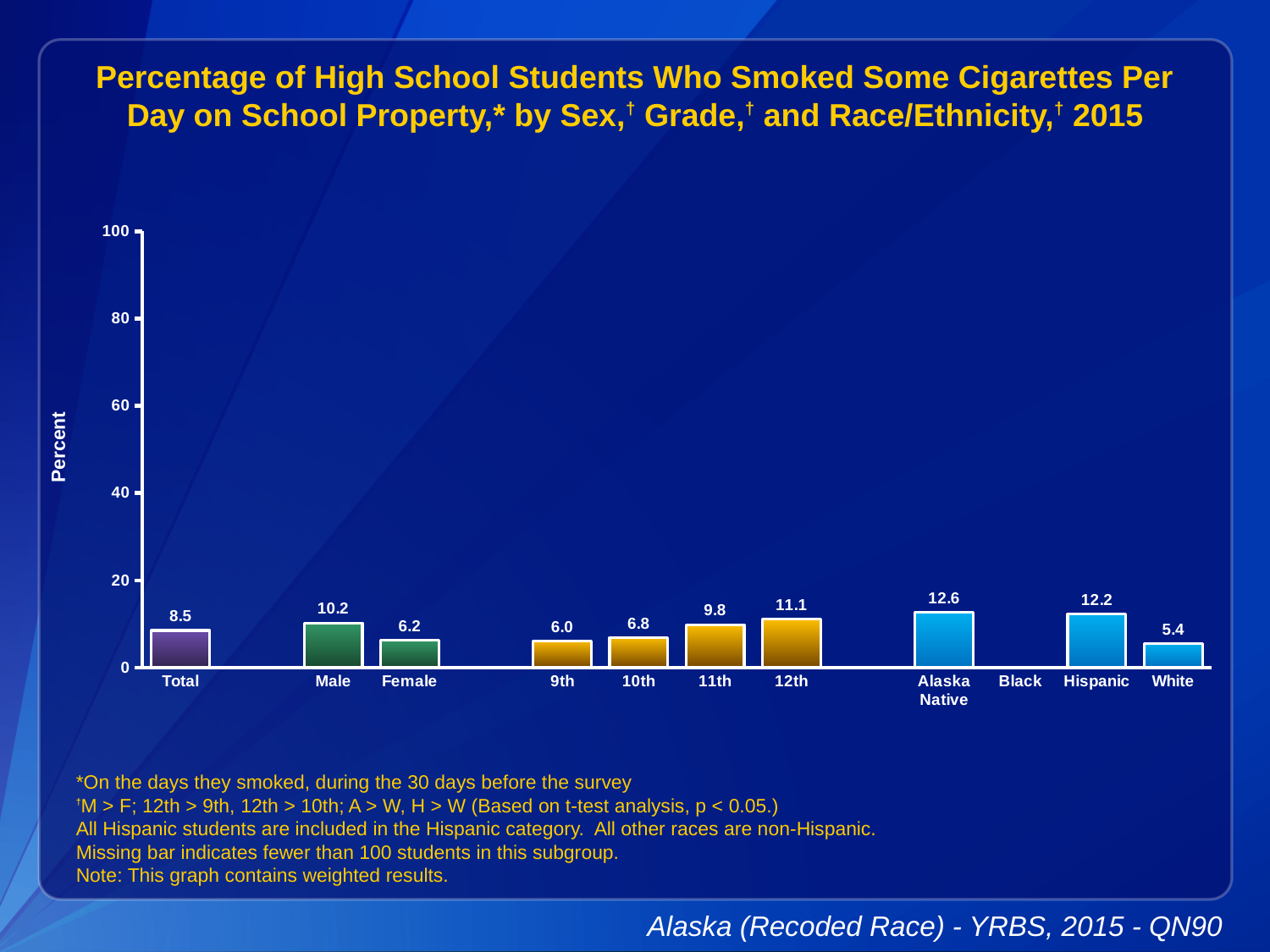
What is the difference between the Male and Female values? 4.0 Is the value for 11th grade greater or less than 20? less What is the value for Total? 8.5 What is the value for Alaska Native? 12.6 What is the value for Male? 10.2 Which is larger, the value for Hispanic or the value for White? Hispanic Which category has no bar shown? Black Which category has the lowest value among those with a bar shown? White What is the value for 12th grade? 11.1 Do the values rise or fall from 9th grade to 12th grade? rise Which category has the highest value? Alaska Native What kind of chart is shown? bar chart